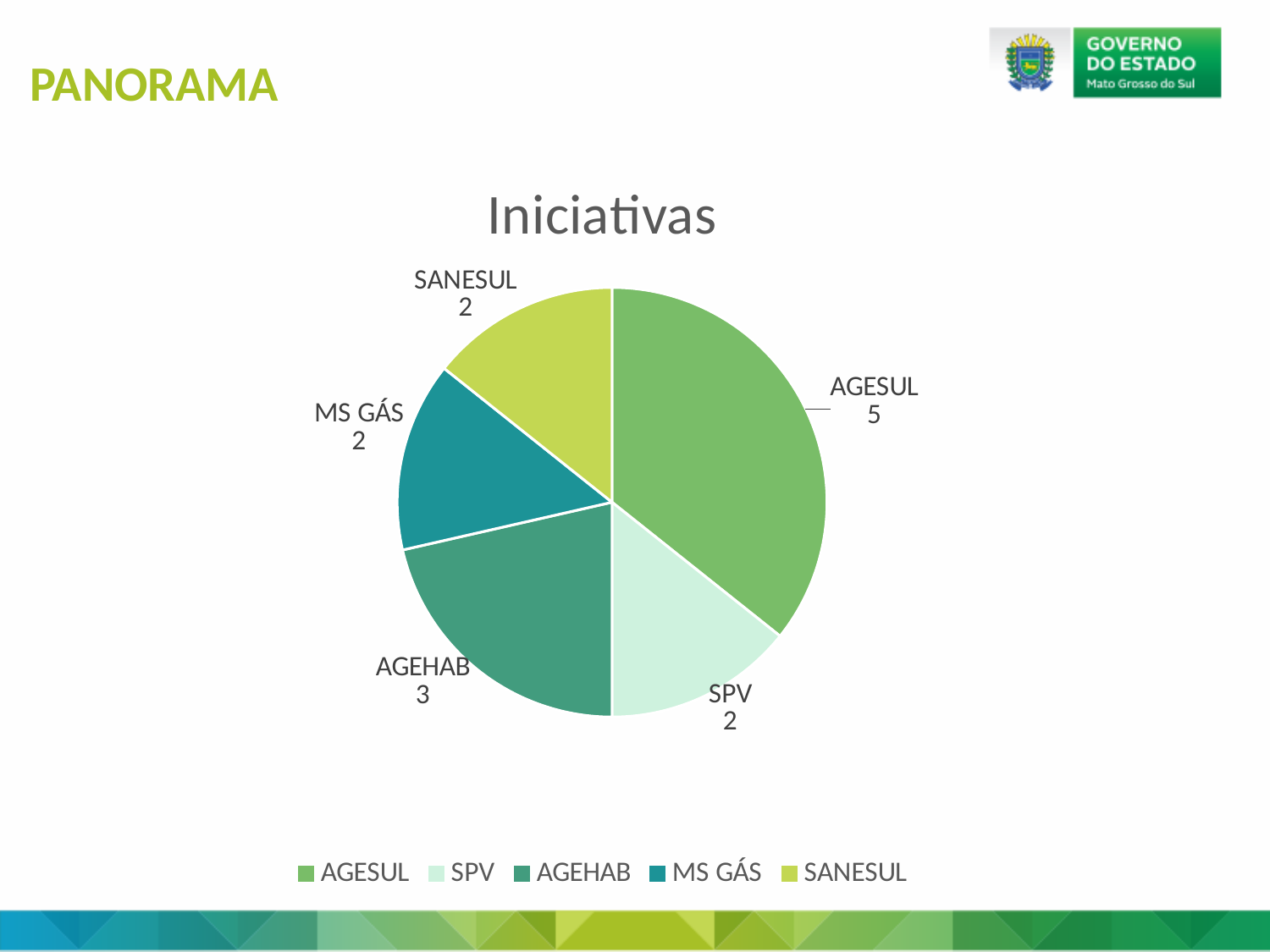
What is the value for AGEHAB? 3 What is the value for SPV? 2 What is the difference between the values for AGESUL and AGEHAB? 2 Which is larger, the value for AGEHAB or the value for SANESUL? AGEHAB What type of chart is shown on the slide? pie chart What is the total of all the values in the pie chart? 14 How many categories are shown in the pie chart? 5 What is the value for MS GÁS? 2 Which category has the largest slice of the pie? AGESUL What is the title of the chart? Iniciativas Which categories share the smallest value in the pie? SPV, MS GÁS, SANESUL What is the value for AGESUL? 5